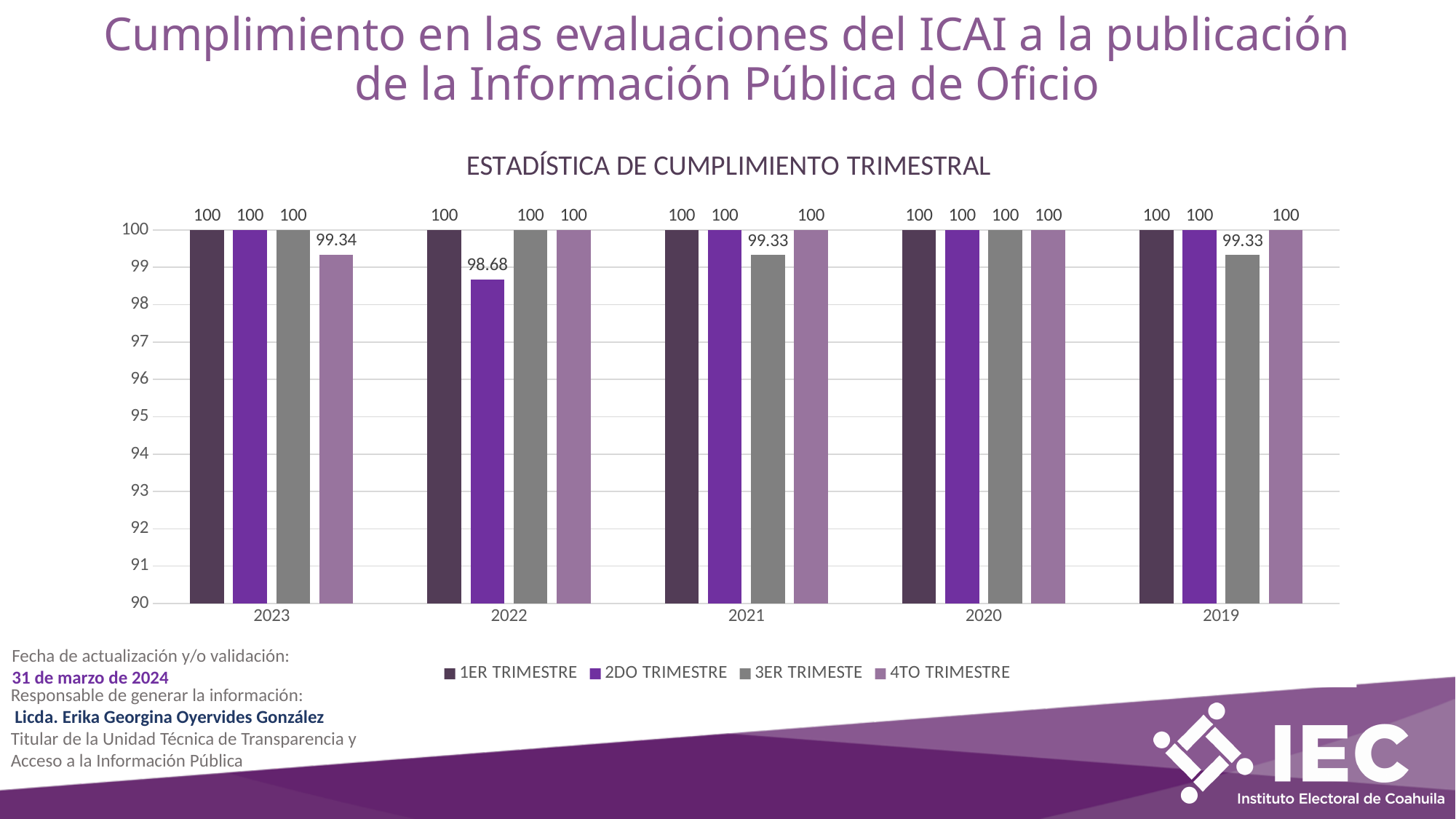
What kind of chart is shown on the slide? Bar chart What is the difference between the 1ER TRIMESTRE and 2DO TRIMESTRE values in 2022? 1.32 Which is larger in 2023: the 3ER TRIMESTE value or the 4TO TRIMESTRE value? 3ER TRIMESTE What is the value for 4TO TRIMESTRE in 2023? 99.34 What is the title of the chart? ESTADÍSTICA DE CUMPLIMIENTO TRIMESTRAL What is the value for 2DO TRIMESTRE in 2022? 98.68 How many series does the legend list? 4 What is the value for 3ER TRIMESTE in 2021? 99.33 Is the value for 2DO TRIMESTRE in 2022 greater or less than 99? less How many years are shown on the x axis? 5 Which year has the lowest single bar in the chart? 2022 What is the value for 1ER TRIMESTRE in 2019? 100